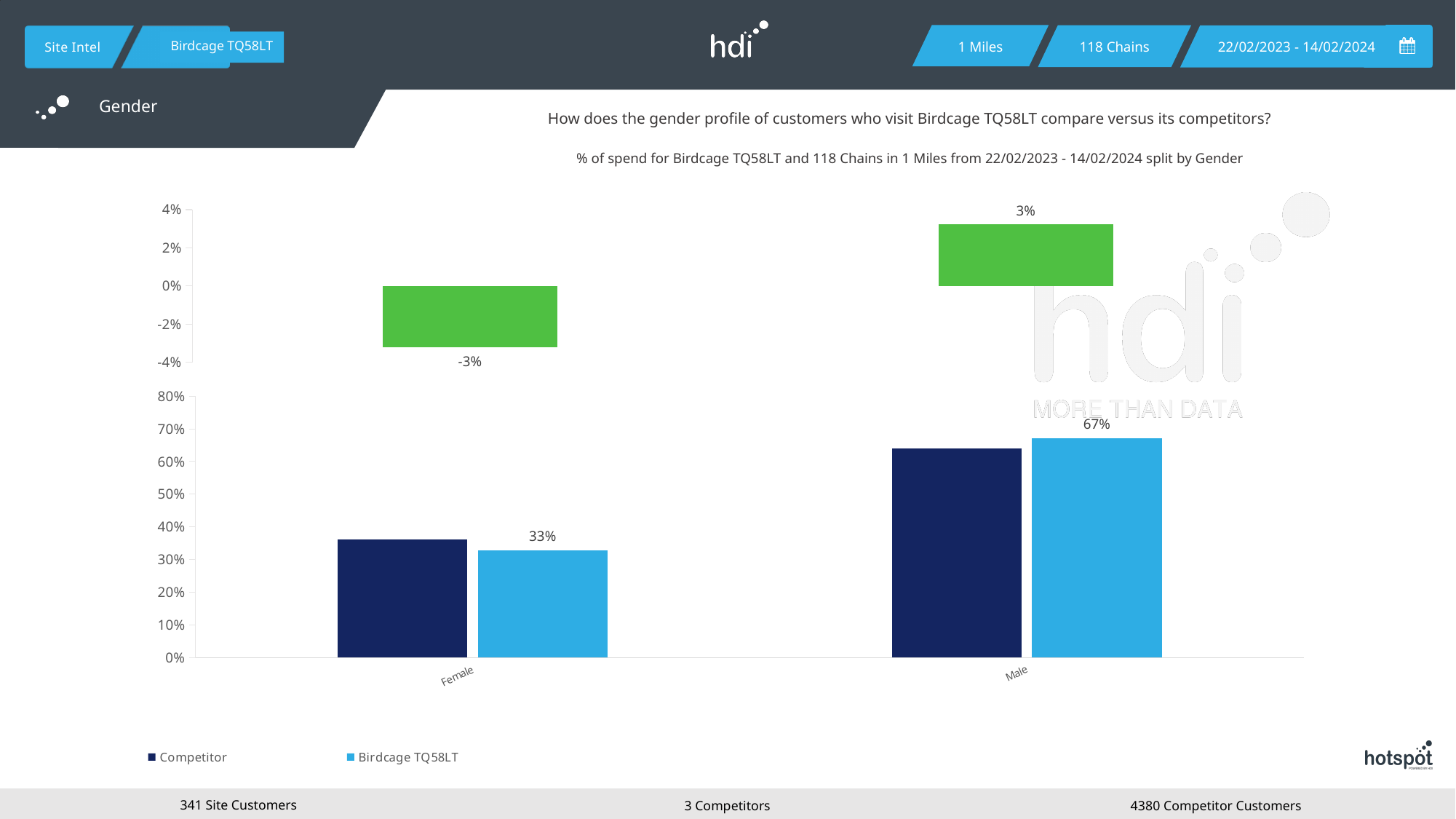
In the lower bar chart, what is the value for Birdcage TQ58LT for Female? 33% In the upper chart with green bars, what is the value shown for Female? -3% In the lower bar chart, for Female, which is larger: the Competitor bar or the Birdcage TQ58LT bar? Competitor In the lower bar chart, is the Competitor value for Female greater or less than 30%? greater In the lower bar chart, which gender has the higher value for Birdcage TQ58LT? Male How many series does the legend of the lower chart list? 2 In the lower bar chart, what is the value for Birdcage TQ58LT for Male? 67% In the lower bar chart, for Male, which is larger: the Competitor bar or the Birdcage TQ58LT bar? Birdcage TQ58LT What type of chart is the lower chart on the slide? Bar chart In the lower bar chart, what is the difference between the Birdcage TQ58LT values for Male and Female? 34% In the upper chart with green bars, what is the value shown for Male? 3% In the lower bar chart, is the Competitor value for Male greater or less than 70%? less